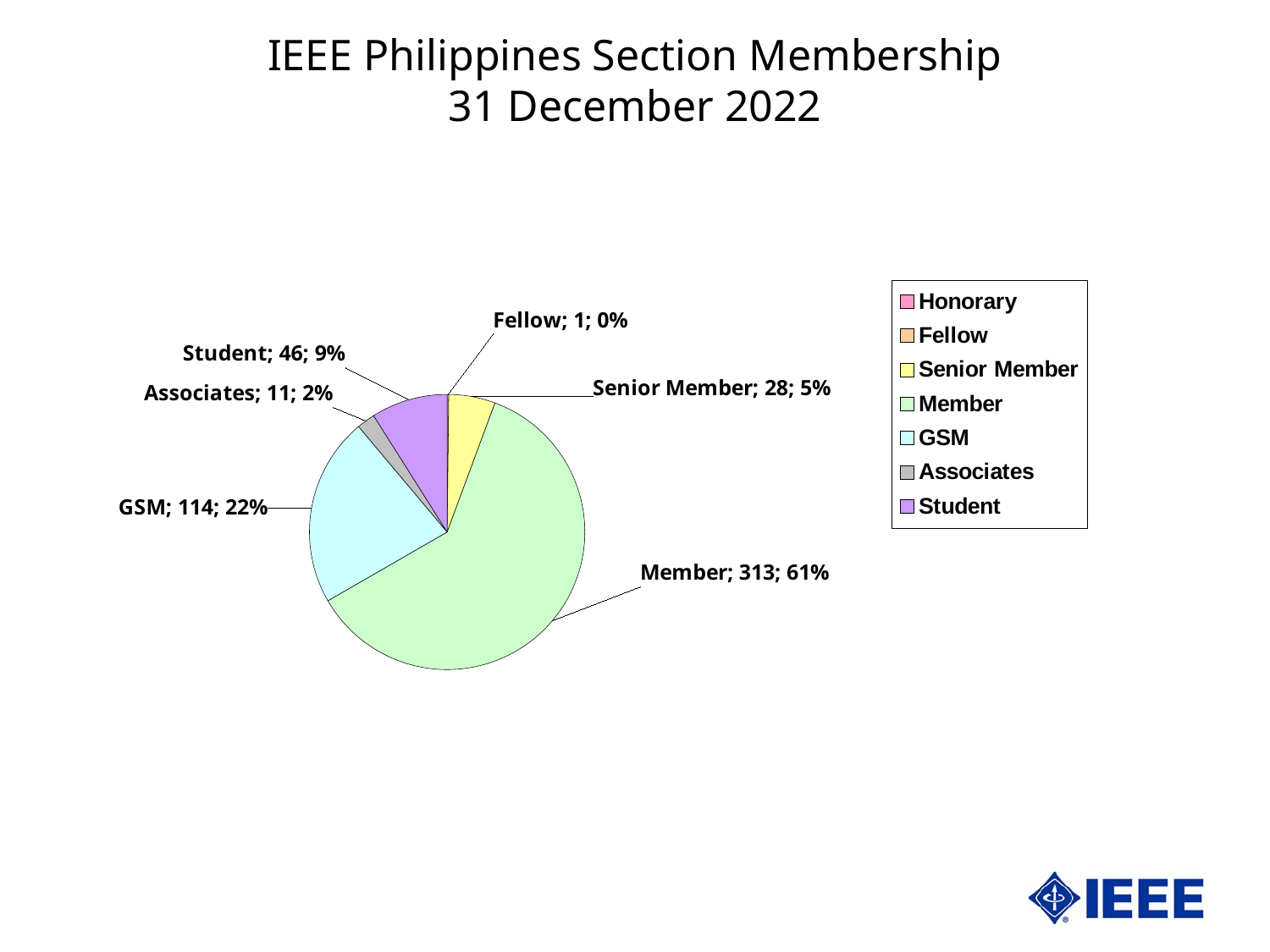
How many entries does the legend list? 7 What percentage share of the pie does the Student category have? 9% What is the title of the slide? IEEE Philippines Section Membership 31 December 2022 How many members are in the Member category? 313 How many members are in the GSM category? 114 Which category has the largest slice of the pie? Member What kind of chart is shown on the slide? pie chart What is the difference between the number of Members and the number of GSM members? 199 What percentage share of the pie does the Senior Member category have? 5% Which labelled category has the smallest slice of the pie? Fellow How many members are in the Associates category? 11 Which is larger, the Student count or the Senior Member count? Student